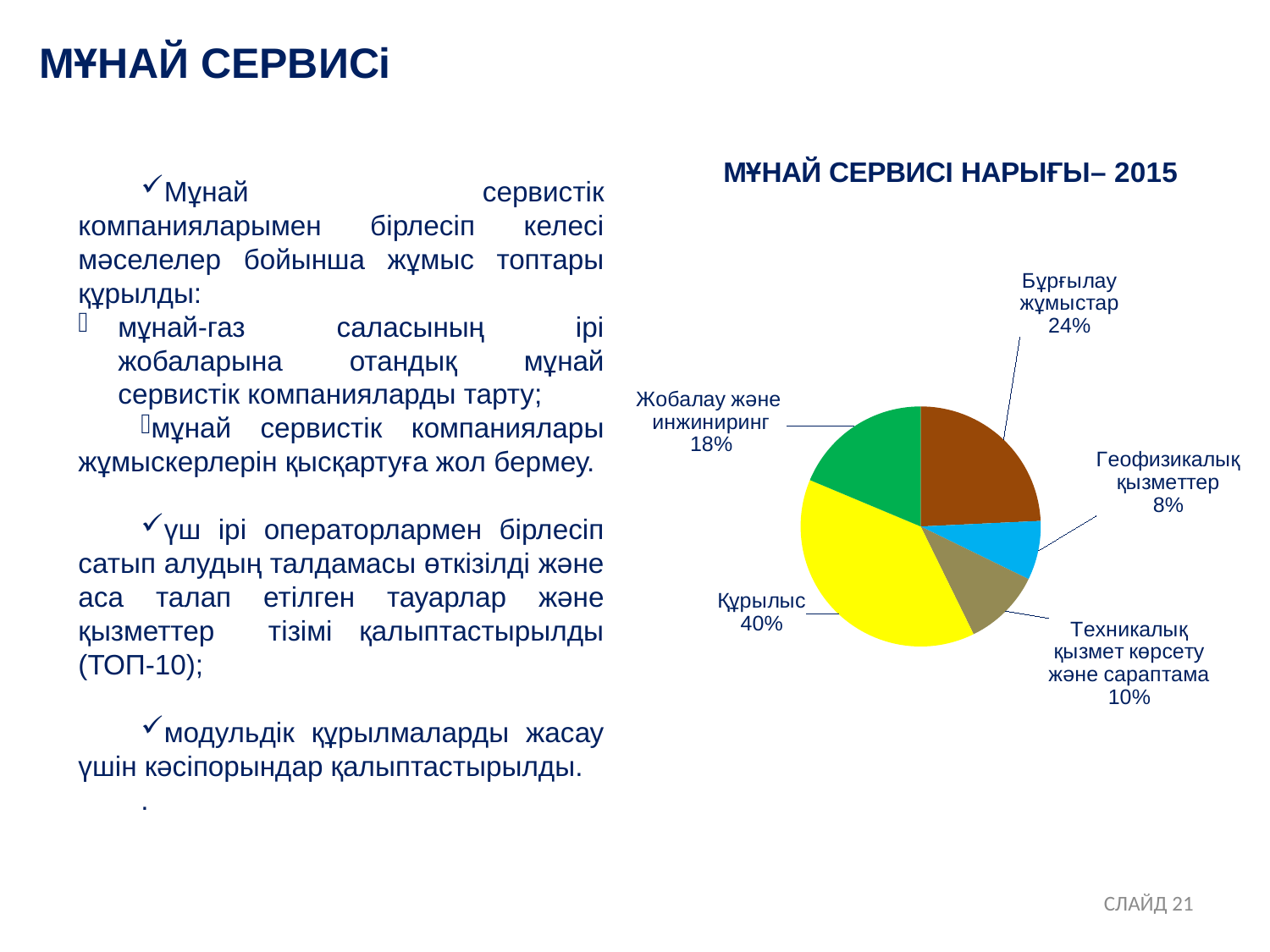
What share of the pie does Бұрғылау жұмыстар have? 24% How many slices does the pie chart have? 5 Which category has the smallest share of the pie? Геофизикалық қызметтер What share of the pie does Техникалық қызмет көрсету және сараптама have? 10% What is the title of the chart? МҰНАЙ СЕРВИСІ НАРЫҒЫ– 2015 What share of the pie does Жобалау және инжиниринг have? 18% Which category has the largest share of the pie? Құрылыс What kind of chart is shown on the slide? pie chart What is the difference in percentage points between Құрылыс and Бұрғылау жұмыстар? 16 Which is larger, the share for Жобалау және инжиниринг or the share for Техникалық қызмет көрсету және сараптама? Жобалау және инжиниринг